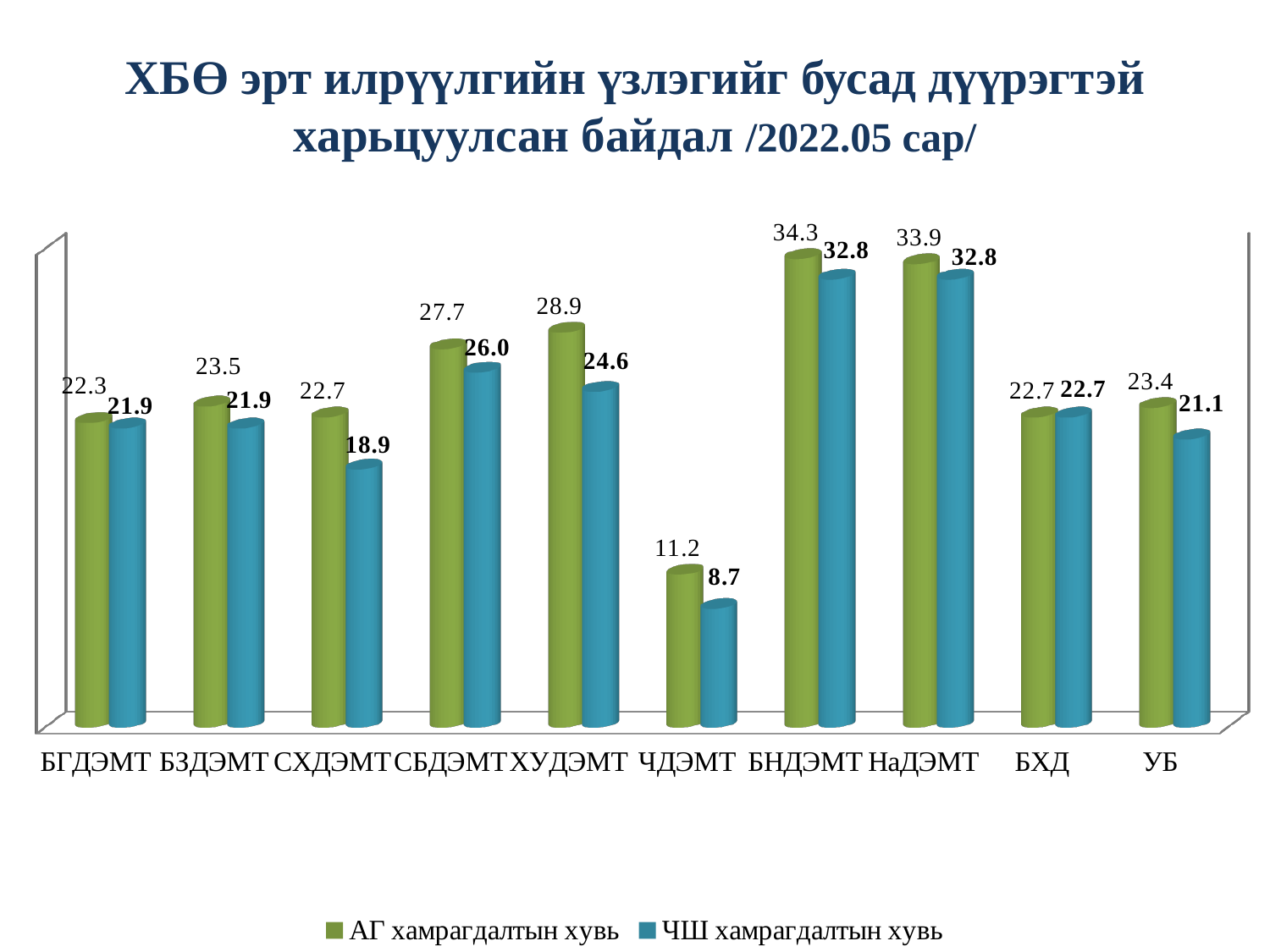
What is the difference between the АГ хамрагдалтын хувь and ЧШ хамрагдалтын хувь values for ХУДЭМТ? 4.3 What is the АГ хамрагдалтын хувь value for ХУДЭМТ? 28.9 What kind of chart is shown on the slide? Bar chart Which category has the lowest ЧШ хамрагдалтын хувь value? ЧДЭМТ Which series is shown in green? АГ хамрагдалтын хувь How many categories are shown on the x axis? 10 What is the ЧШ хамрагдалтын хувь value for ЧДЭМТ? 8.7 What is the difference between the АГ хамрагдалтын хувь values for БНДЭМТ and НаДЭМТ? 0.4 What is the ЧШ хамрагдалтын хувь value for СХДЭМТ? 18.9 Which category has the highest АГ хамрагдалтын хувь value? БНДЭМТ How many series does the legend list? 2 Which is larger: the ЧШ хамрагдалтын хувь value for СБДЭМТ or for УБ? СБДЭМТ